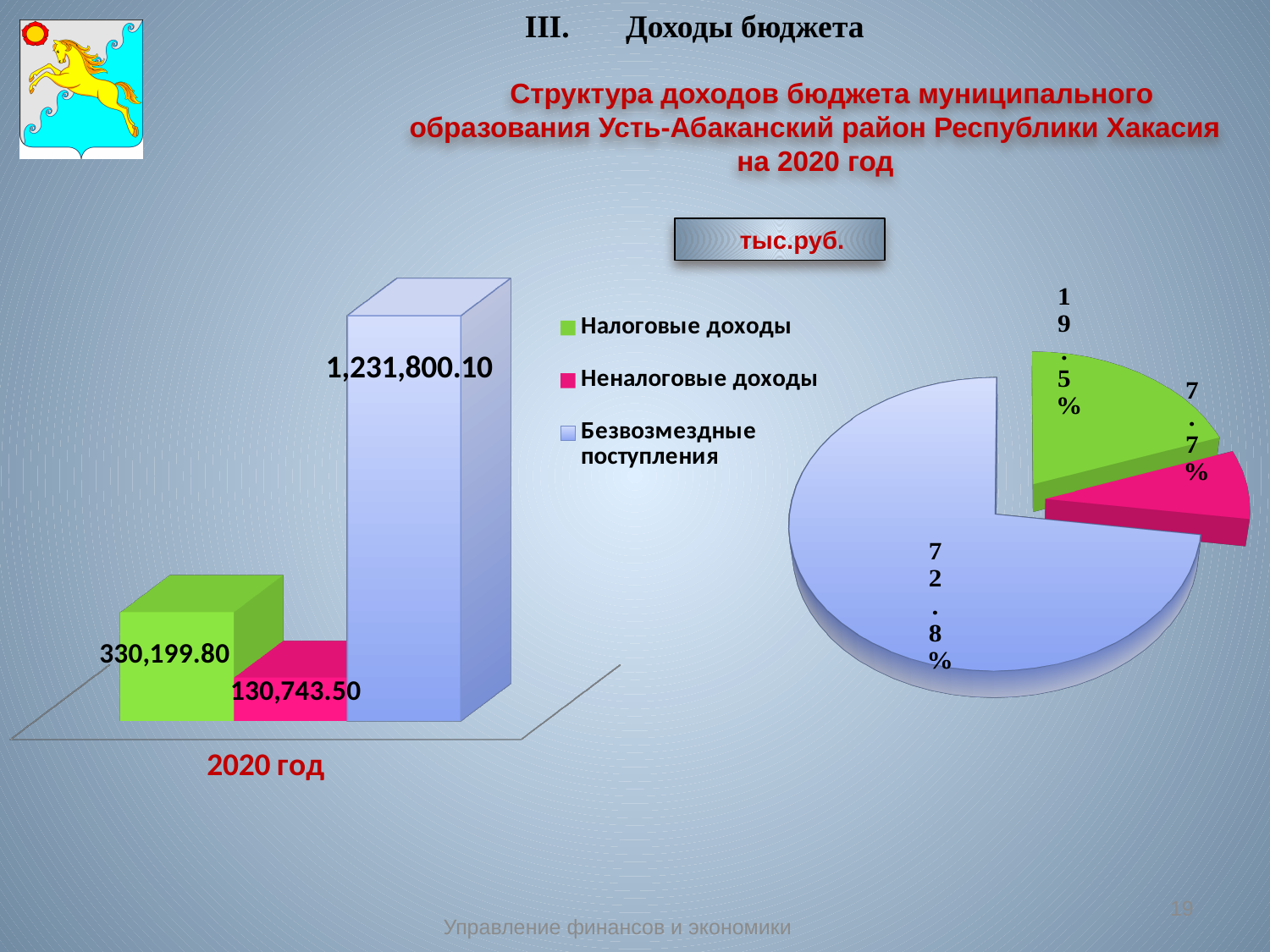
On the bar chart on the left, what is the value for Неналоговые доходы? 130,743.50 On the bar chart on the left, what is the value for Налоговые доходы? 330,199.80 On the bar chart on the left, which series has the highest value? Безвозмездные поступления On the bar chart on the left, what is the difference between Налоговые доходы and Неналоговые доходы? 199,456.30 How many series does the legend of the bar chart on the left list? 3 What kind of chart is shown on the left of the slide? bar chart On the pie chart on the right, what share does the green slice (Налоговые доходы) have? 19.5% On the bar chart on the left, which is larger: Налоговые доходы or Неналоговые доходы? Налоговые доходы On the bar chart on the left, which year is shown on the category axis? 2020 год On the pie chart on the right, what share does the largest slice have? 72.8% On the bar chart on the left, which series has the lowest value? Неналоговые доходы On the bar chart on the left, what is the value for Безвозмездные поступления? 1,231,800.10